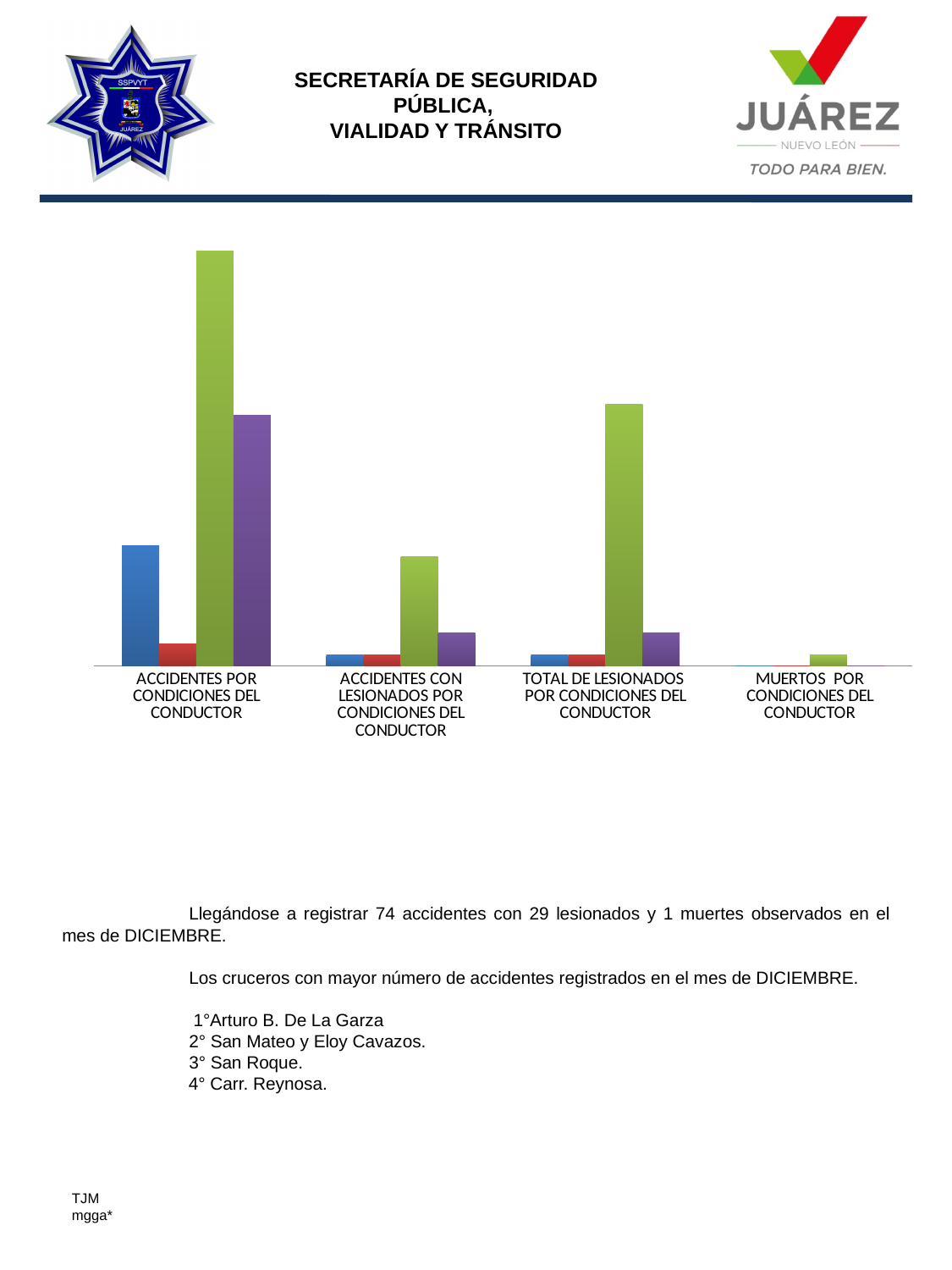
Is the green bar taller for ACCIDENTES CON LESIONADOS POR CONDICIONES DEL CONDUCTOR or for TOTAL DE LESIONADOS POR CONDICIONES DEL CONDUCTOR? TOTAL DE LESIONADOS POR CONDICIONES DEL CONDUCTOR Which category has the shortest bars overall in the chart? MUERTOS POR CONDICIONES DEL CONDUCTOR In the ACCIDENTES POR CONDICIONES DEL CONDUCTOR category, which is taller, the blue bar or the red bar? The blue bar Which category contains the tallest bar in the chart? ACCIDENTES POR CONDICIONES DEL CONDUCTOR Which colour bar is the tallest in the TOTAL DE LESIONADOS POR CONDICIONES DEL CONDUCTOR category? Green Is the purple bar taller for ACCIDENTES POR CONDICIONES DEL CONDUCTOR or for TOTAL DE LESIONADOS POR CONDICIONES DEL CONDUCTOR? ACCIDENTES POR CONDICIONES DEL CONDUCTOR What kind of chart is shown on the slide? Bar chart Does the chart show data labels with the values of the bars? No How many bars are plotted for each category in the chart? 4 Does the chart display a legend? No How many categories are shown along the x axis of the chart? 4